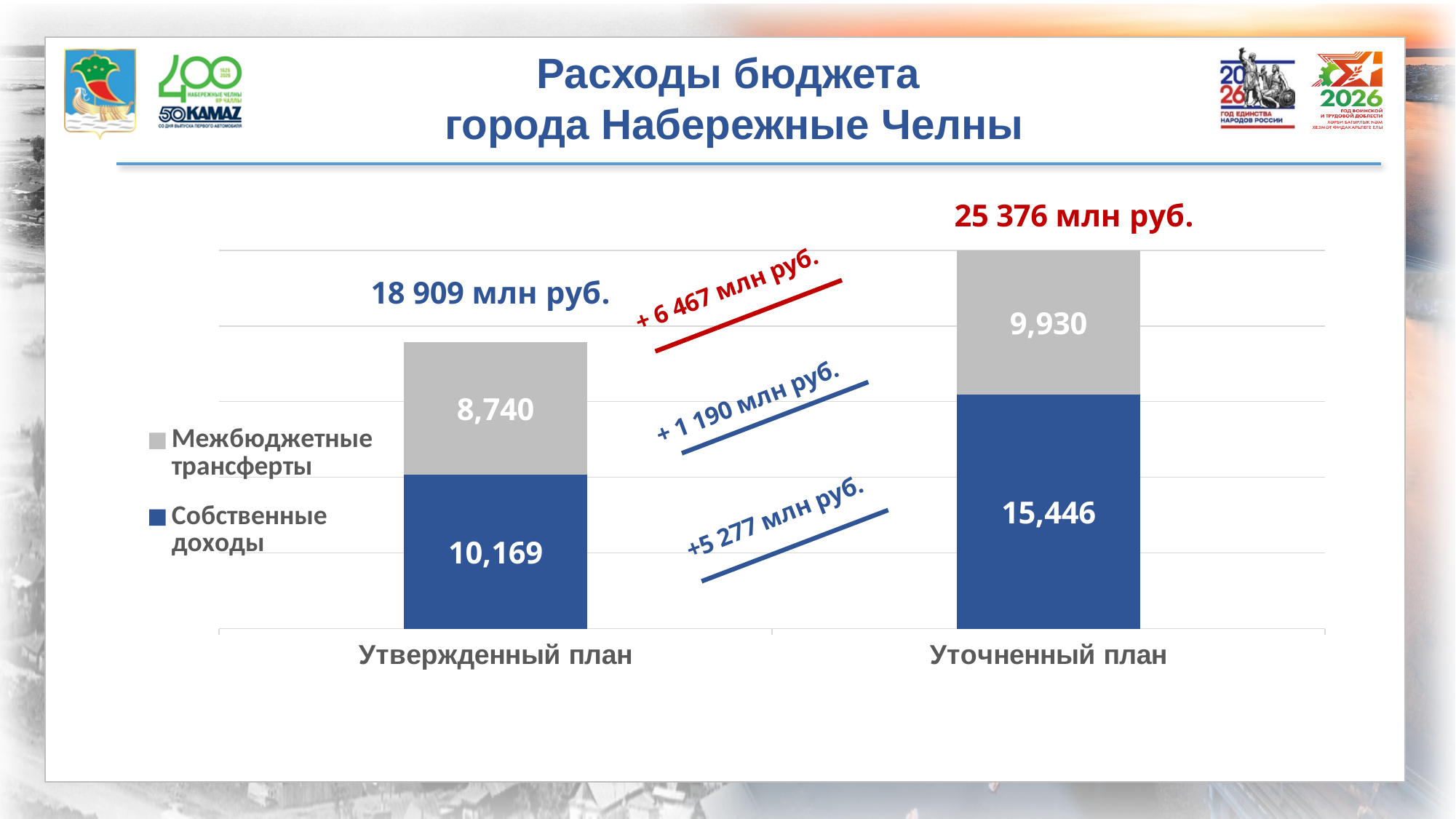
By how much does Межбюджетные трансферты increase from Утвержденный план to Уточненный план? 1 190 млн руб. What is the value of Межбюджетные трансферты for Уточненный план? 9,930 How many categories are shown on the x axis? 2 What is the value of Собственные доходы for Уточненный план? 15,446 What is the value of Собственные доходы for Утвержденный план? 10,169 What is the value of Межбюджетные трансферты for Утвержденный план? 8,740 Which category has the higher value for Собственные доходы, Утвержденный план or Уточненный план? Уточненный план What is the total shown for the Уточненный план bar? 25 376 млн руб. How many series does the legend list? 2 What is the total shown for the Утвержденный план bar? 18 909 млн руб. What kind of chart is shown on the slide? Stacked bar chart By how much does Собственные доходы increase from Утвержденный план to Уточненный план? 5 277 млн руб.